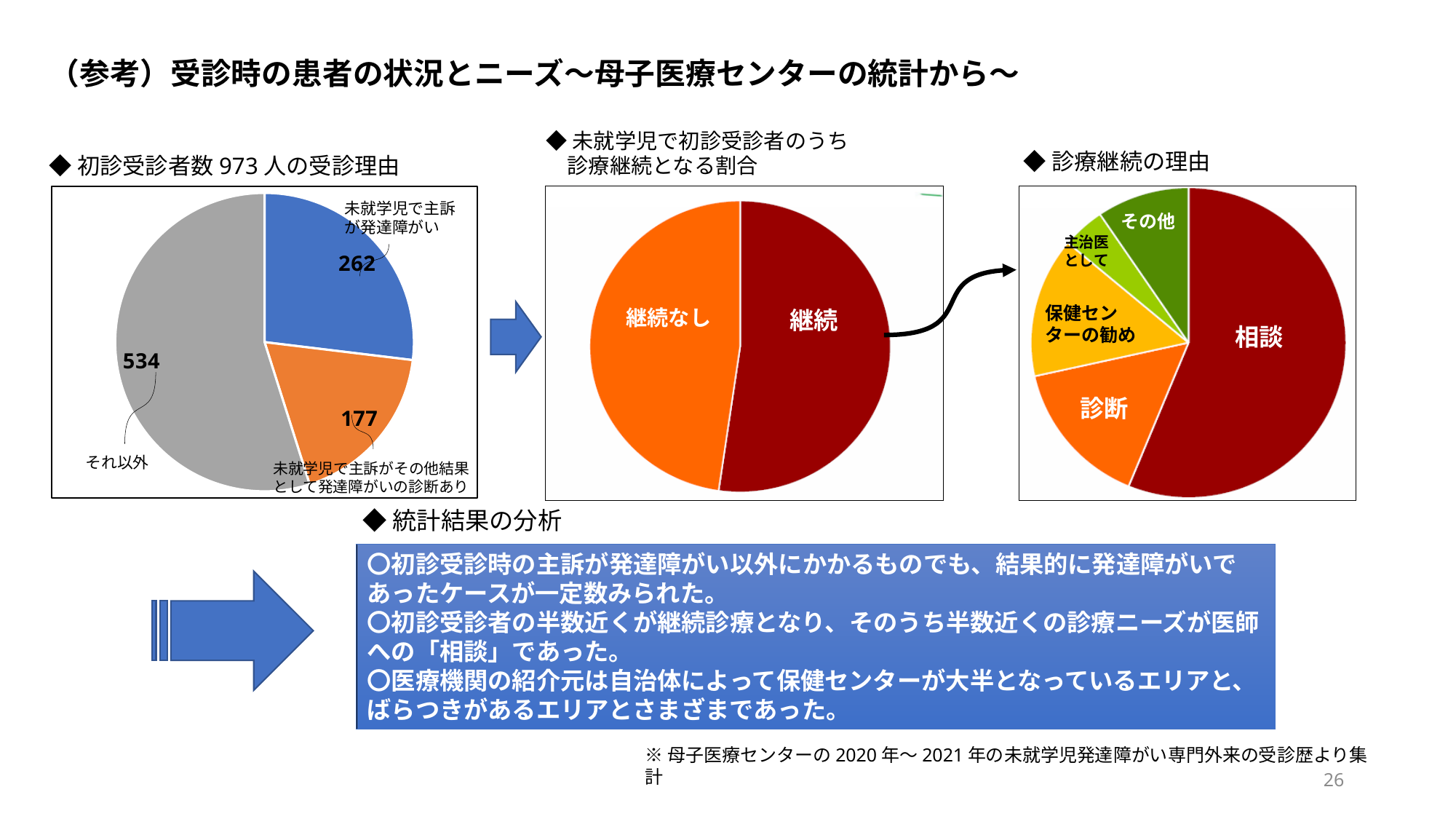
What kind of chart is the middle chart (未就学児で初診受診者のうち診療継続となる割合)? Pie chart In the left pie chart (初診受診者数973人の受診理由), what is the value for 未就学児で主訴が発達障がい? 262 In the left pie chart (初診受診者数973人の受診理由), which category has the smallest value? 未就学児で主訴がその他結果として発達障がいの診断あり How many slices does the middle pie chart (未就学児で初診受診者のうち診療継続となる割合) have? 2 In the right pie chart (診療継続の理由), which is larger, 診断 or 保健センターの勧め? 診断 In the left pie chart (初診受診者数973人の受診理由), what is the value for それ以外? 534 In the left pie chart (初診受診者数973人の受診理由), what is the difference between それ以外 and 未就学児で主訴が発達障がい? 272 In the right pie chart (診療継続の理由), which reason has the largest share? 相談 How many slices does the left pie chart (初診受診者数973人の受診理由) have? 3 In the left pie chart (初診受診者数973人の受診理由), what is the value for 未就学児で主訴がその他結果として発達障がいの診断あり? 177 In the left pie chart (初診受診者数973人の受診理由), which category has the largest value? それ以外 In the left pie chart (初診受診者数973人の受診理由), what is the total of the three slices? 973